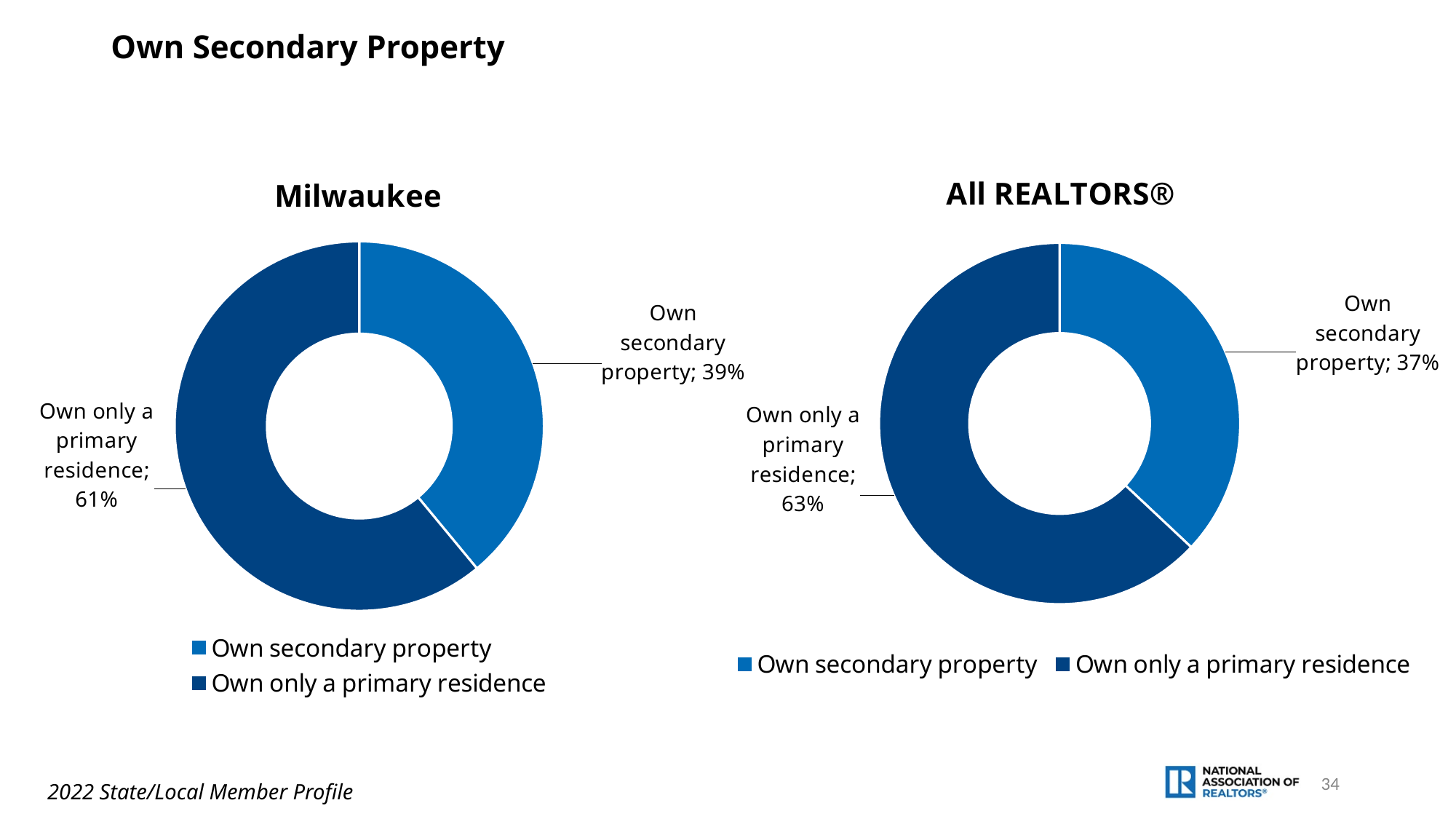
In the Milwaukee chart, what percentage of members own secondary property? 39% Which is larger: the share owning secondary property in the Milwaukee chart or in the All REALTORS® chart? Milwaukee In the Milwaukee chart, what is the difference between the share that own only a primary residence and the share that own secondary property? 22% How many entries does the legend of the All REALTORS® chart list? 2 How many categories does the Milwaukee chart show? 2 What type of chart is the All REALTORS® chart? Doughnut chart In the Milwaukee chart, which category has the largest share? Own only a primary residence What is the title of the slide? Own Secondary Property In the All REALTORS® chart, which category has the smallest share? Own secondary property In the All REALTORS® chart, what percentage of members own secondary property? 37% In the Milwaukee chart, what percentage of members own only a primary residence? 61% In the All REALTORS® chart, what percentage of members own only a primary residence? 63%